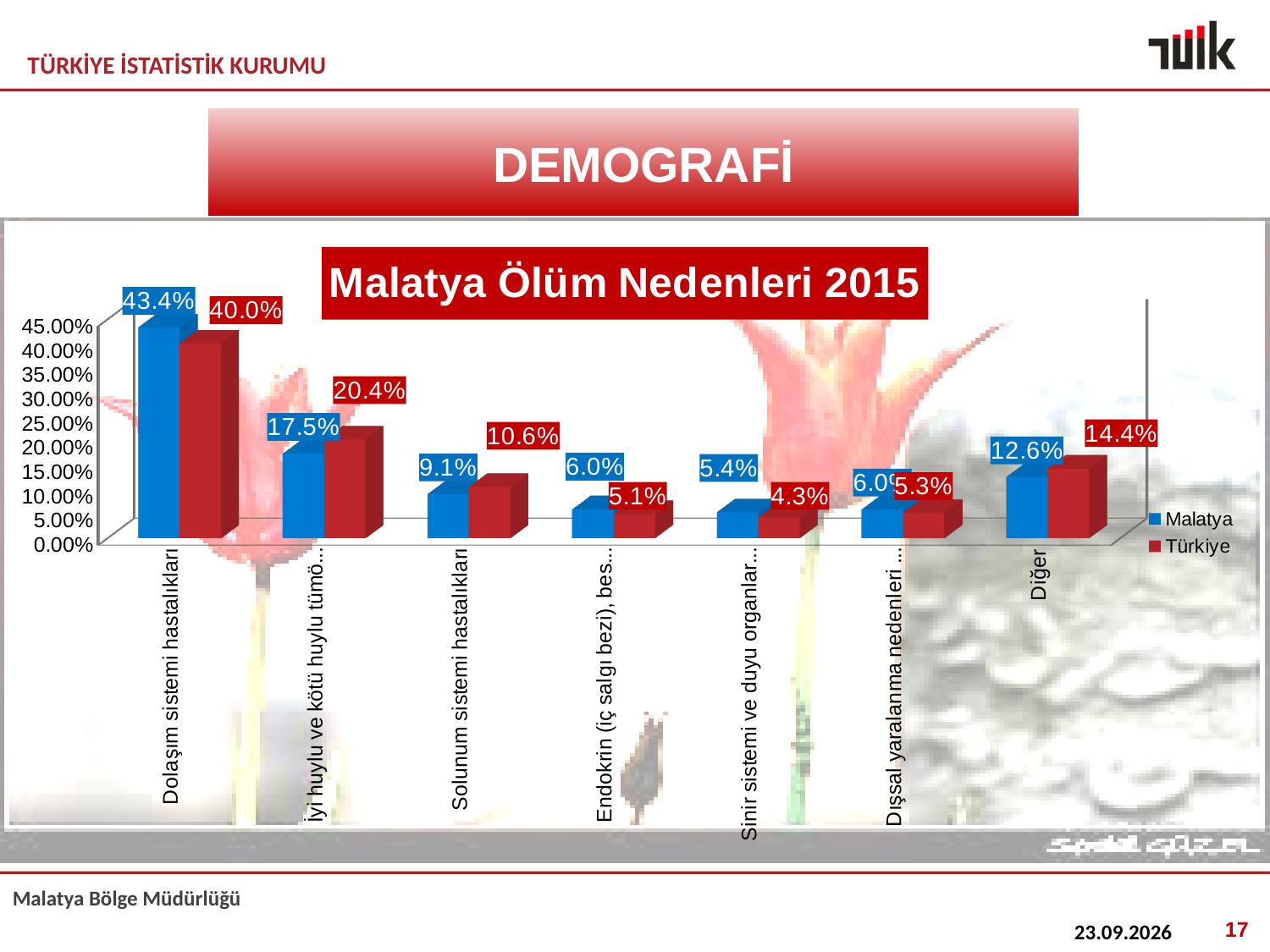
What is the Türkiye value for Dolaşım sistemi hastalıkları? 40.0% What is the Malatya value for Dolaşım sistemi hastalıkları? 43.4% How many categories are shown on the x axis? 7 Which category has the highest Malatya value? Dolaşım sistemi hastalıkları For Diğer, which is larger: the Malatya value or the Türkiye value? Türkiye What is the Malatya value for Solunum sistemi hastalıkları? 9.1% What kind of chart is shown on the slide? Bar chart What is the difference between the Malatya and Türkiye values for Dolaşım sistemi hastalıkları? 3.4 percentage points What is the Malatya value for Diğer? 12.6% How many series does the legend list? 2 What is the Türkiye value for Solunum sistemi hastalıkları? 10.6% What is the Türkiye value for Diğer? 14.4%